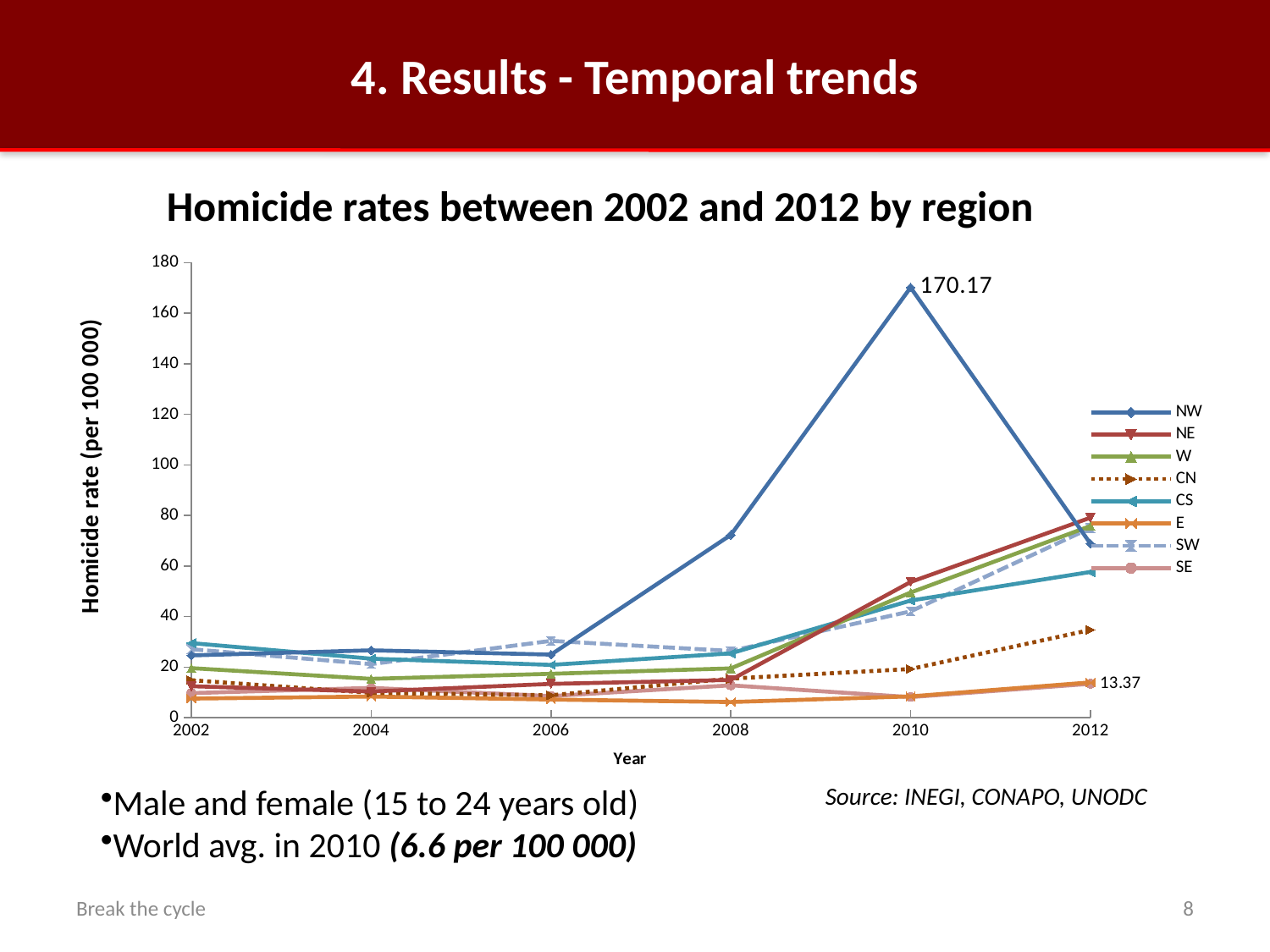
What is the title of the chart? Homicide rates between 2002 and 2012 by region Which is larger in 2010, the value for NW or the value for NE? NW Does the NW line rise or fall between 2008 and 2010? Rise Is the value for NW in 2008 greater or less than 60? greater How many series does the chart legend list? 8 What type of chart is shown on the slide? Line chart Is the value for E in 2010 greater or less than 20? less What is the homicide rate for the NW region in 2010? 170.17 Which region reaches the highest value anywhere on the chart? NW How many years are plotted along the x axis? 6 Which region has the highest homicide rate in 2010? NW Is the value for CN in 2012 greater or less than 20? greater